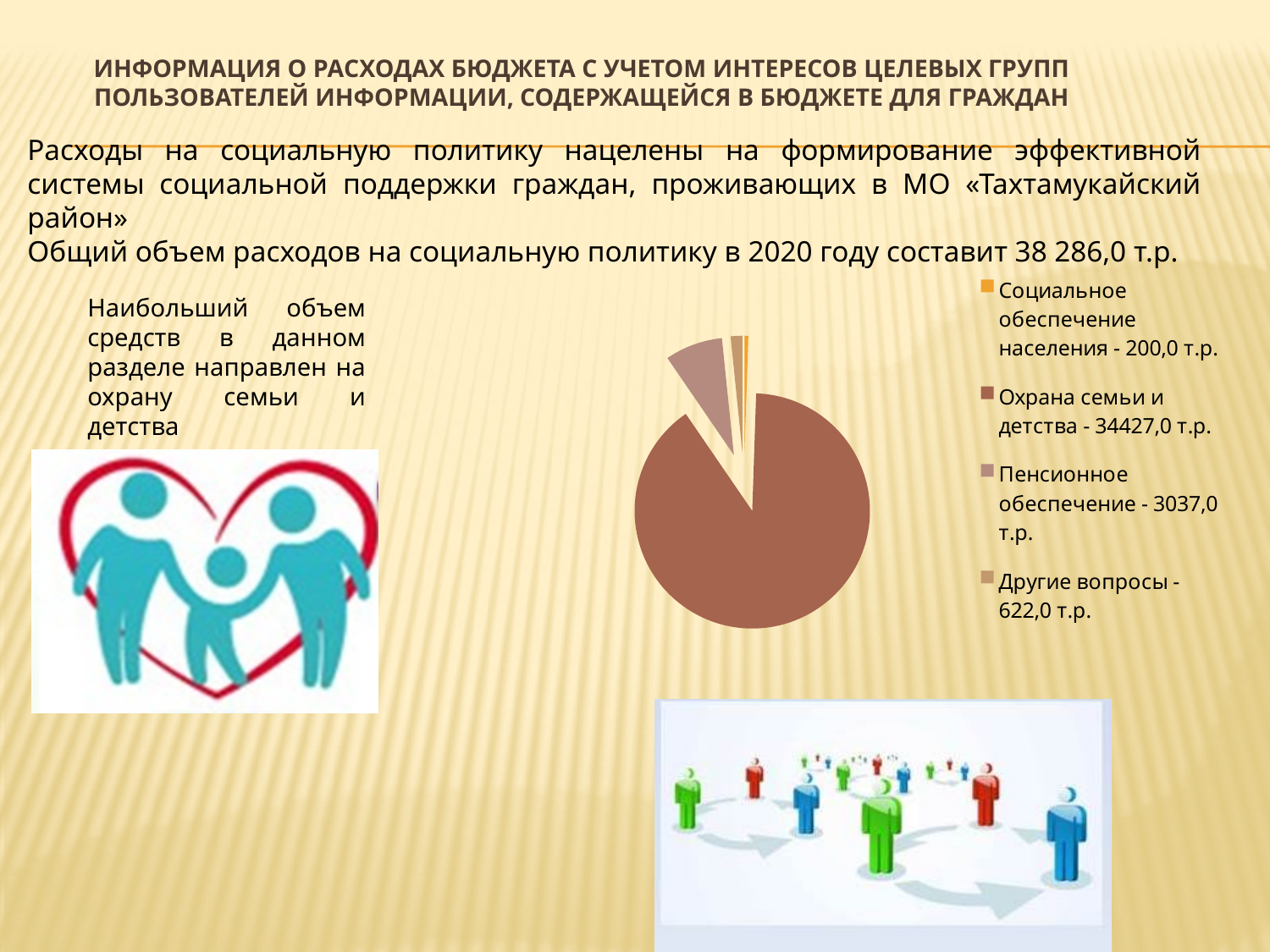
Which is larger: Пенсионное обеспечение or Другие вопросы? Пенсионное обеспечение What value does the legend give for Охрана семьи и детства in the pie chart? 34427,0 т.р. What kind of chart is shown on the slide? Pie chart What value does the legend give for Другие вопросы in the pie chart? 622,0 т.р. What value does the legend give for Пенсионное обеспечение in the pie chart? 3037,0 т.р. Which category has the smallest slice in the pie chart? Социальное обеспечение населения What is the difference between the values for Охрана семьи и детства and Пенсионное обеспечение? 31390,0 т.р. What is the total of all four categories in the pie chart, as stated on the slide? 38 286,0 т.р. What is the difference between the values for Другие вопросы and Социальное обеспечение населения? 422,0 т.р. How many categories does the pie chart show? 4 What value does the legend give for Социальное обеспечение населения in the pie chart? 200,0 т.р. Which category has the largest slice in the pie chart? Охрана семьи и детства